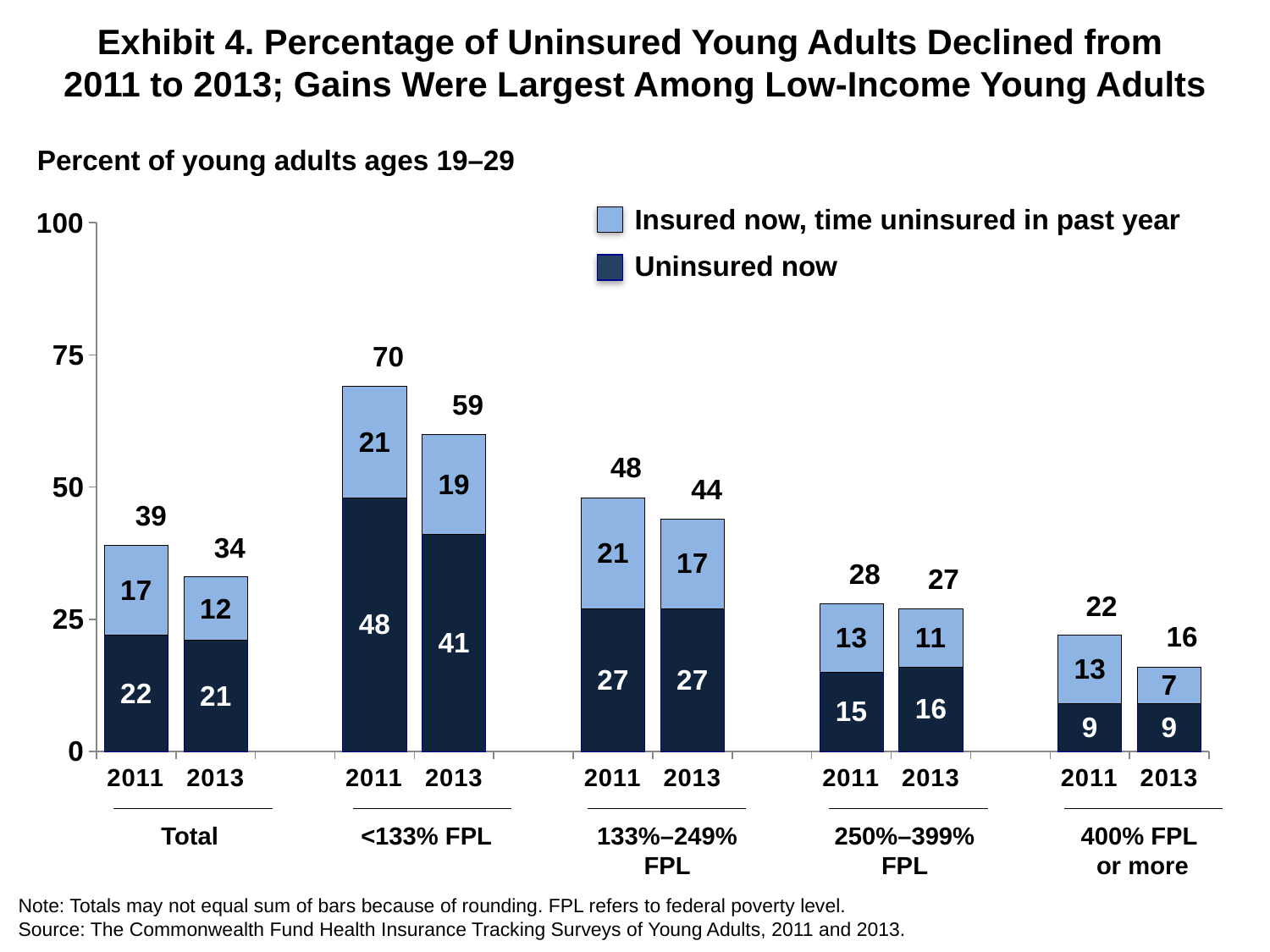
Is the 'Uninsured now' value for 133%–249% FPL larger in 2011 or 2013? They are equal (27) What is the difference between the 'Uninsured now' values for <133% FPL in 2011 and 2013? 7 Which series is shown in dark navy in the legend? Uninsured now What is the 'Insured now, time uninsured in past year' value for Total in 2013? 12 Which income group has the lowest total in 2013? 400% FPL or more How many bars are plotted on the chart? 10 What kind of chart is shown on the slide? Stacked bar chart Is the total for <133% FPL in 2011 greater or less than 50? greater What is the total printed above the 2013 bar for 250%–399% FPL? 27 How many series does the legend list? 2 Which income group has the highest total in 2011? <133% FPL What is the 'Uninsured now' value for <133% FPL in 2011? 48